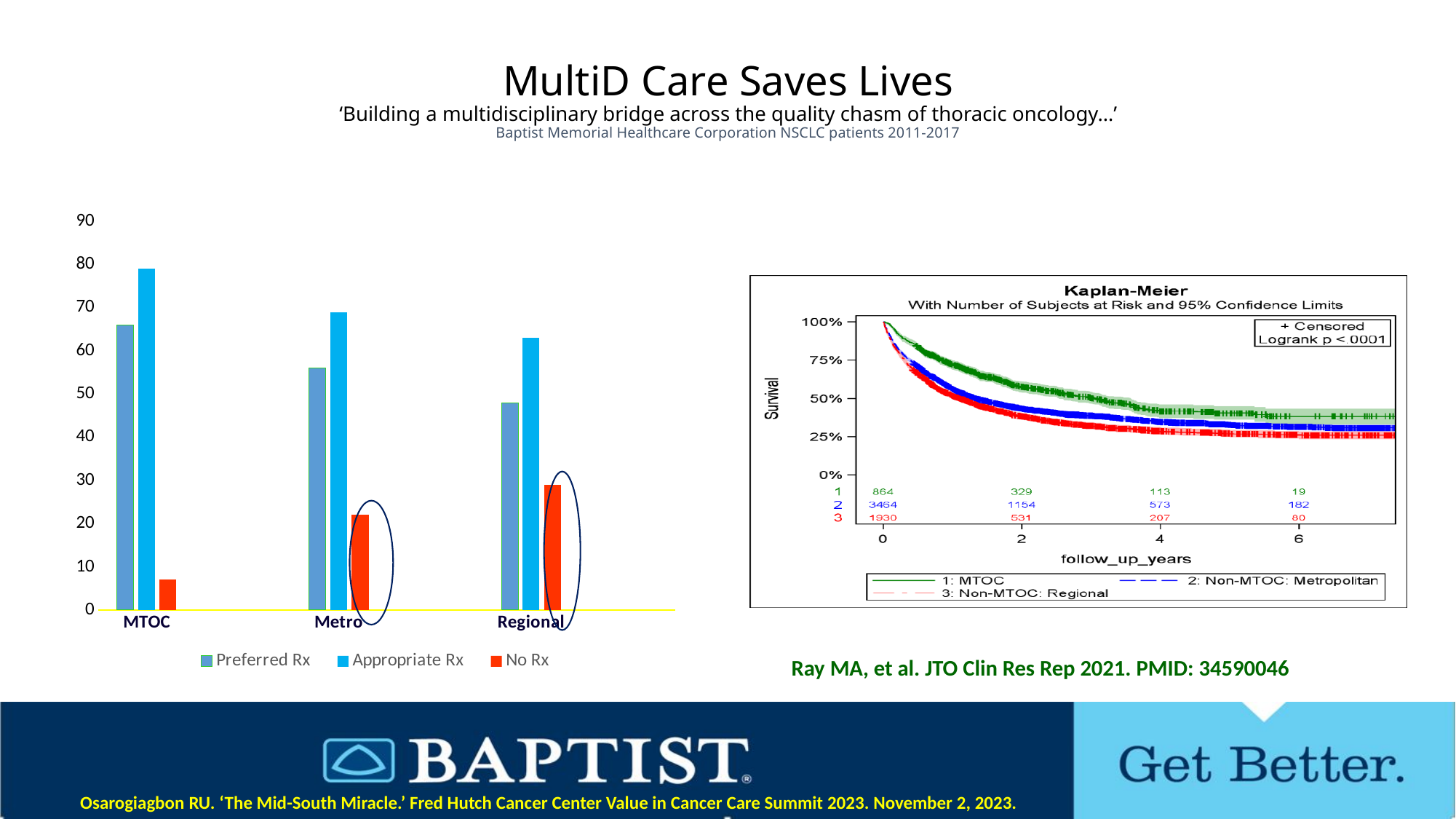
In the bar chart on the left, which category has the highest No Rx bar? Regional In the bar chart on the left, is the No Rx value for MTOC greater or less than 10? less In the Kaplan-Meier chart on the right, how many subjects were at risk in group 2 (Non-MTOC: Metropolitan) at 2 follow-up years? 1154 In the Kaplan-Meier chart on the right, how many subjects were at risk in group 1 (MTOC) at 0 follow-up years? 864 How many categories are shown on the x axis of the bar chart on the left? 3 In the bar chart on the left, is the Preferred Rx value for Metro greater or less than 50? greater In the bar chart on the left, is the Appropriate Rx value for MTOC greater or less than 70? greater How many series does the legend of the bar chart on the left list? 3 What kind of chart is the chart on the left of the slide? bar chart In the bar chart on the left, is the Appropriate Rx bar for MTOC larger or smaller than the Appropriate Rx bar for Regional? larger In the bar chart on the left, which category has the lowest Preferred Rx bar? Regional In the Kaplan-Meier chart on the right, what is the difference between the number of subjects at risk at 0 years in group 2 (3464) and group 3 (1930)? 1534